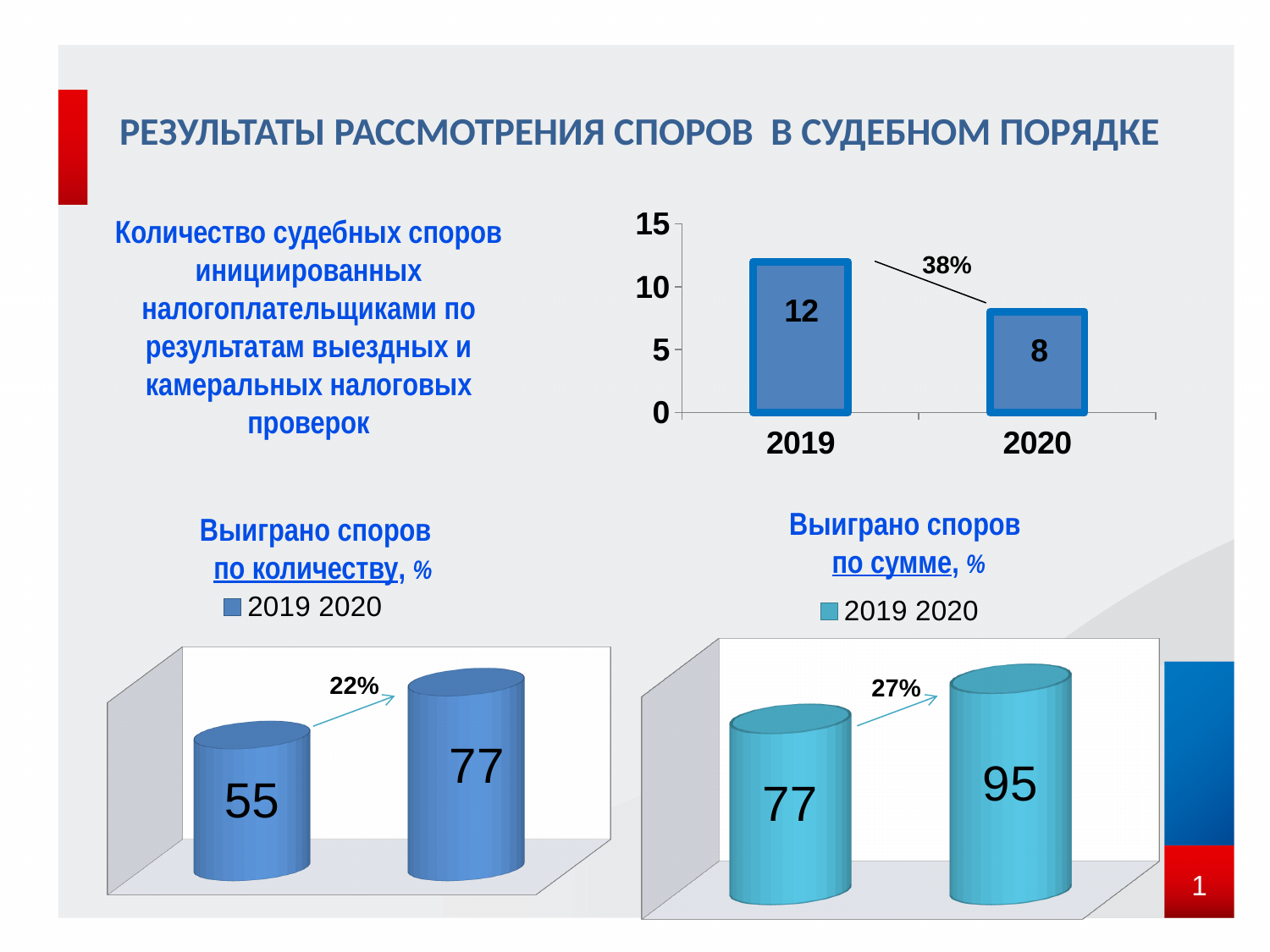
In the top-right chart showing the number of court disputes, by how much did the value fall from 2019 to 2020? 4 What kind of chart is the top-right chart showing the number of court disputes? bar chart In the bottom-left chart 'Выиграно споров по количеству, %', what is the value for 2019? 55 In the bottom-right chart 'Выиграно споров по сумме, %', what is the value for 2020? 95 In the bottom-left chart 'Выиграно споров по количеству, %', what is the value for 2020? 77 In the top-right chart showing the number of court disputes, do the values rise or fall from 2019 to 2020? fall In the top-right chart showing the number of court disputes, which year has the higher value? 2019 In the top-right chart showing the number of court disputes, what percentage change is annotated between the two bars? 38% In the bottom-right chart 'Выиграно споров по сумме, %', which year has the lower value? 2019 In the bottom-left chart 'Выиграно споров по количеству, %', what is the difference between the 2020 and 2019 values? 22 In the top-right chart showing the number of court disputes, what is the value for 2019? 12 In the top-right chart showing the number of court disputes, what is the value for 2020? 8